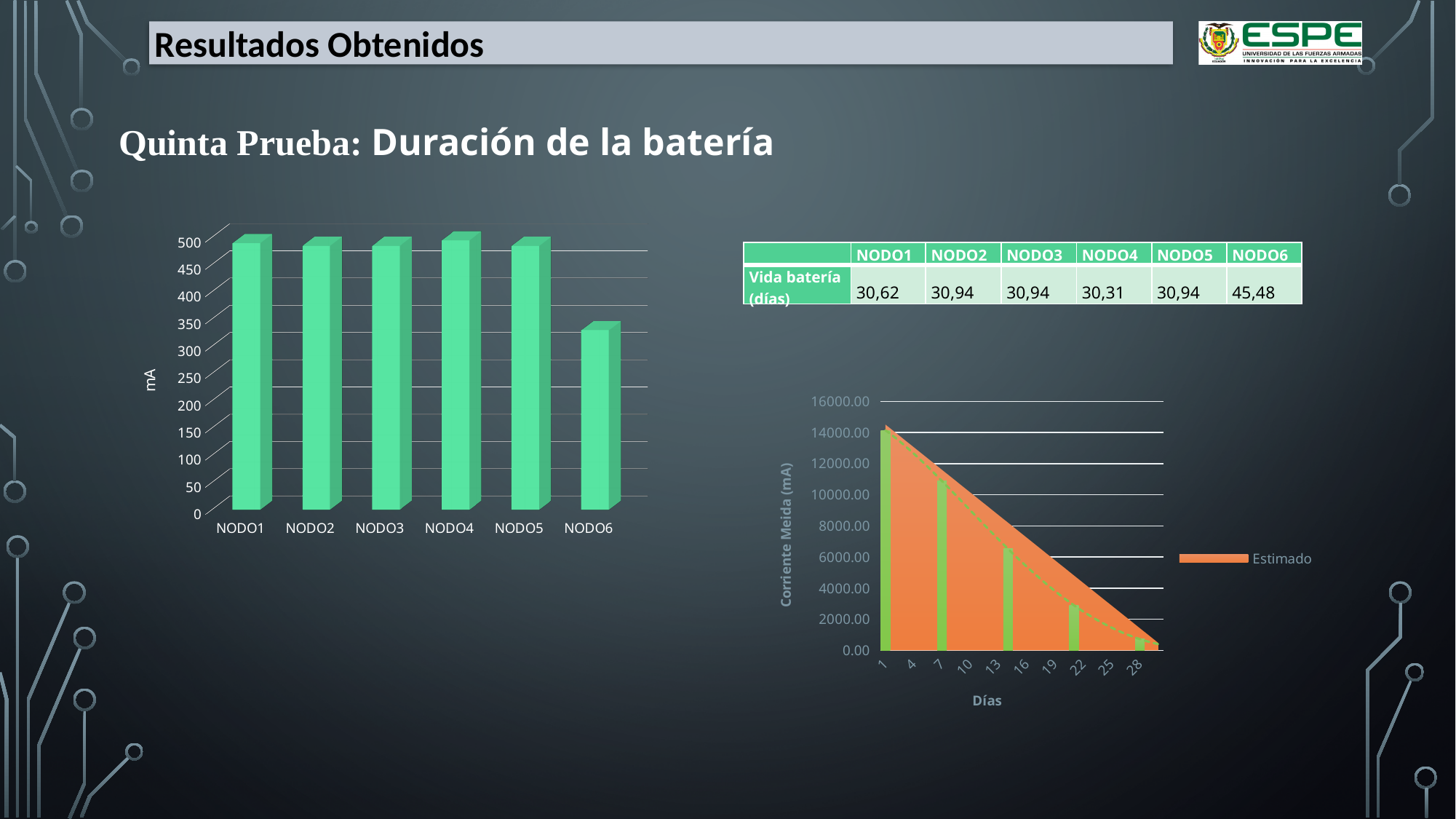
In the left bar chart, which is larger, the value for NODO4 or the value for NODO6? NODO4 In the left bar chart, how many nodes are shown on the x axis? 6 In the left bar chart, is the value for NODO1 greater or less than 450? greater In the right chart, do the values rise or fall as the days increase? fall In the left bar chart, is the value for NODO6 greater or less than 400? less What type of chart is the left chart showing mA per node? bar chart In the left bar chart, which node has the lowest value? NODO6 What is the name of the series in the legend of the right chart? Estimado What is the label on the vertical axis of the left bar chart? mA In the right chart, is the value at day 1 greater or less than 12000.00? greater How many series does the legend of the right chart list? 1